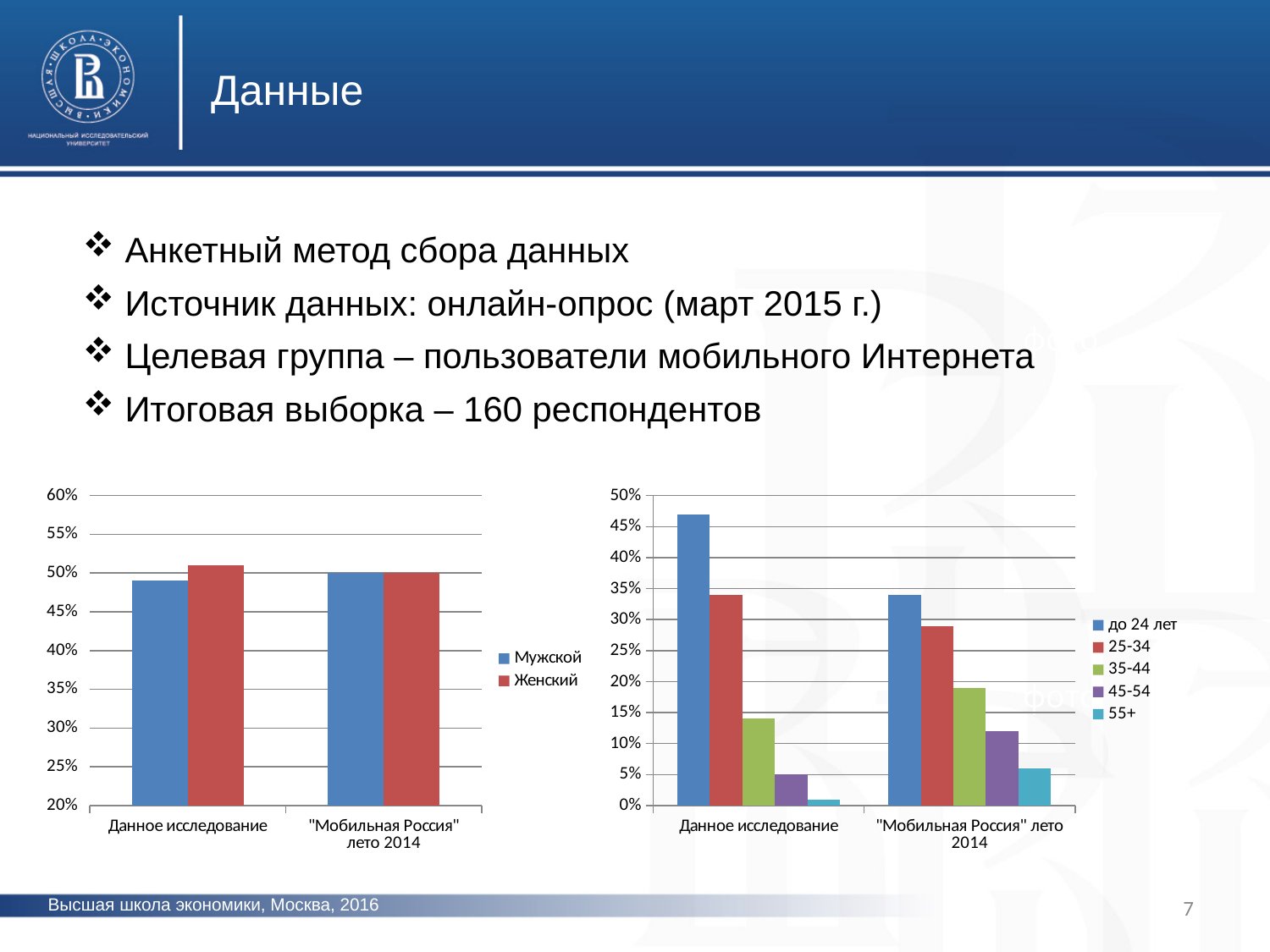
In the right chart, is the value for до 24 лет in Данное исследование greater or less than 45%? greater In the right chart, is the value for до 24 лет larger in Данное исследование or in "Мобильная Россия" лето 2014? Данное исследование In the right chart, which age group has the lowest value for Данное исследование? 55+ In the right chart, which age group has the highest value for Данное исследование? до 24 лет In the left chart, what is the value for Мужской in "Мобильная Россия" лето 2014? 50% In the left chart, how many series does the legend list? 2 In the left chart, which is larger for Данное исследование: Мужской or Женский? Женский In the right chart, how many series does the legend list? 5 What kind of chart is the left chart on the slide? bar chart In the right chart, which legend entry is shown in light blue (teal)? 55+ In the right chart, how many categories are shown on the x axis? 2